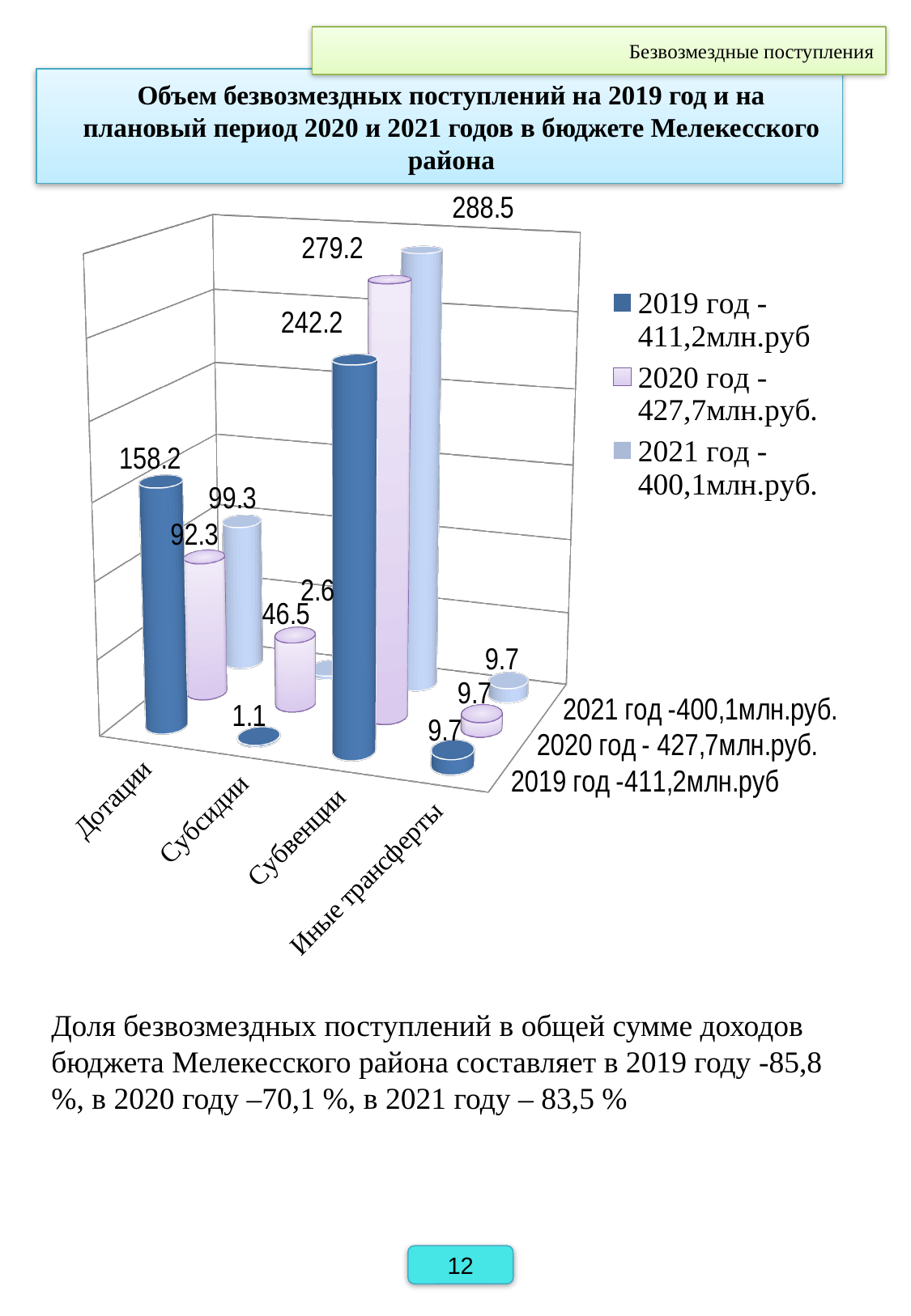
What is the value for Субвенции in the 2021 год series? 288.5 How many series does the legend list? 3 How many categories are shown on the x axis? 4 What is the value for Иные трансферты in the 2019 год series? 9.7 Which category has the highest value in the 2020 год series? Субвенции What total for 2020 год is given in the legend? 427,7млн.руб. What kind of chart is shown on the slide? Bar chart Which category has the lowest value in the 2019 год series? Субсидии What is the value for Дотации in the 2019 год series? 158.2 Which is larger for Дотации: the 2020 год value or the 2021 год value? 2021 год What is the value for Субсидии in the 2020 год series? 46.5 What is the difference between the 2021 год and 2019 год values for Субвенции? 46.3